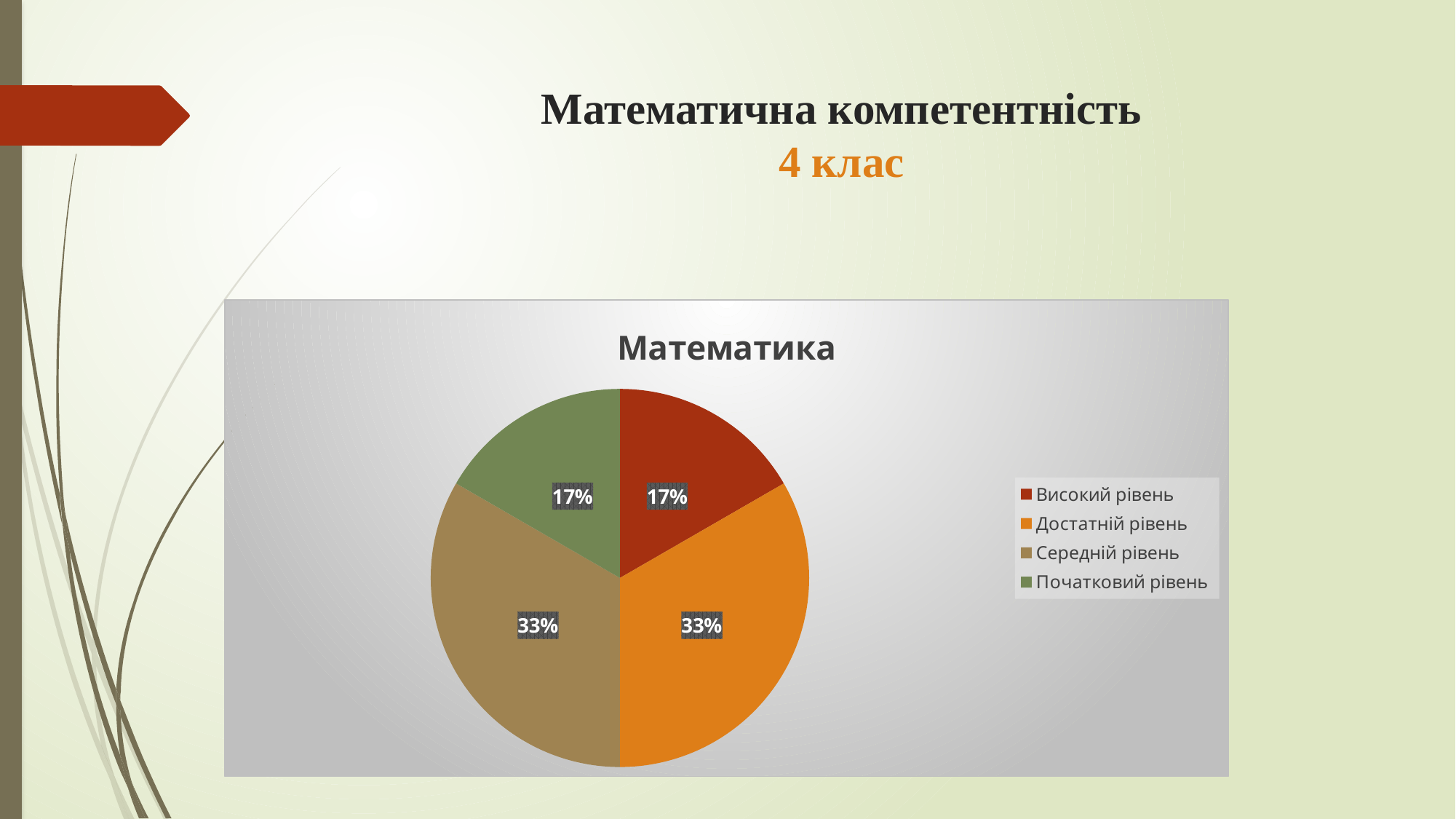
What share of the pie does Середній рівень have? 33% How many entries does the legend list? 4 What share of the pie does Достатній рівень have? 33% What kind of chart is shown on the slide? pie chart Which colour represents Початковий рівень in the legend? green What is the difference between the share for Середній рівень and the share for Початковий рівень? 16% What share of the pie does Високий рівень have? 17% How many slices does the pie chart have? 4 Which is larger, the share for Достатній рівень or the share for Високий рівень? Достатній рівень Which is larger, the share for Середній рівень or the share for Початковий рівень? Середній рівень What is the title of the chart? Математика